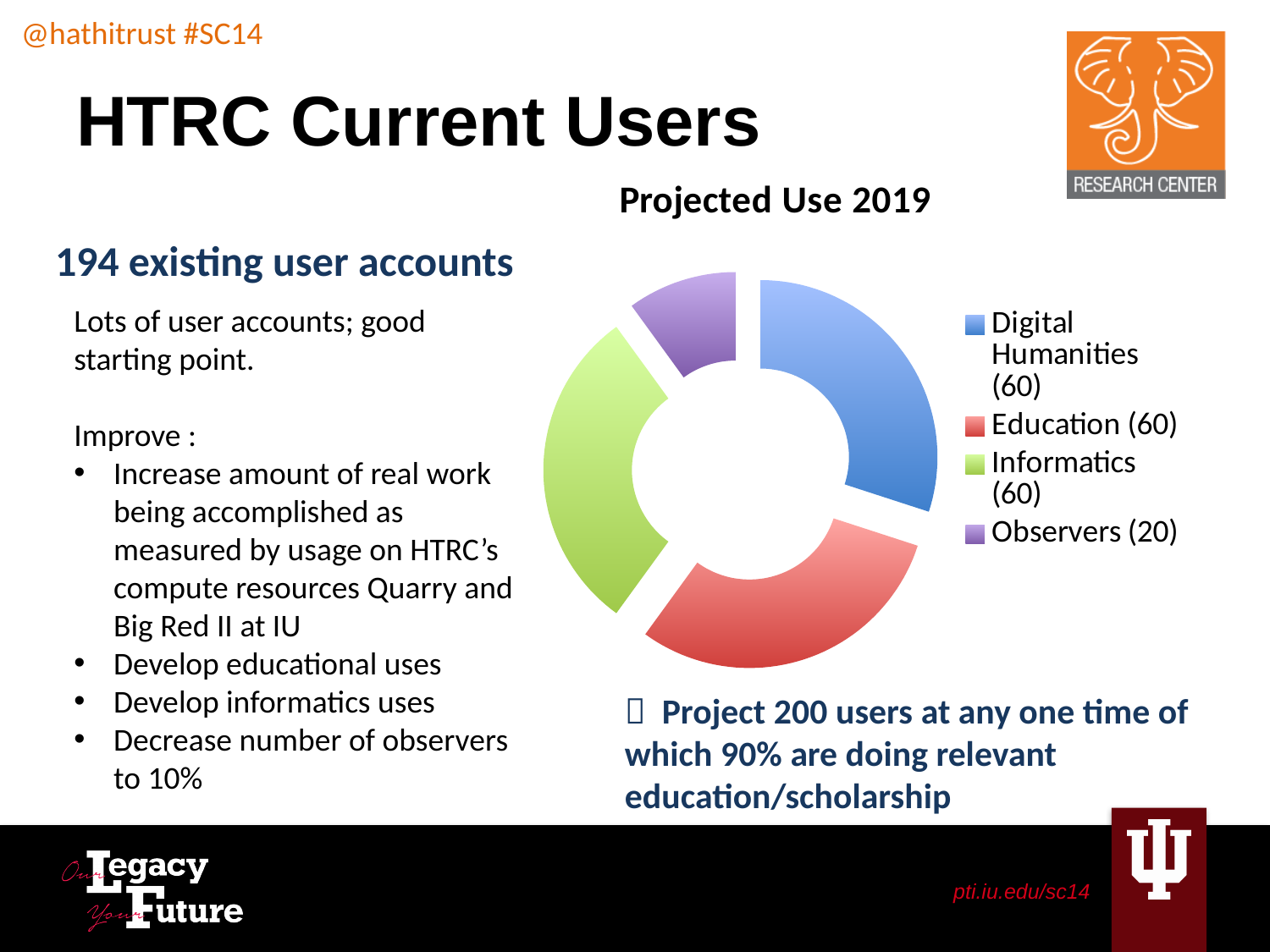
What kind of chart is the Projected Use 2019 chart? Doughnut (pie) chart How many categories does the Projected Use 2019 chart show? 4 What is the value for Informatics in the Projected Use 2019 chart? 60 What colour represents Informatics in the Projected Use 2019 chart? Green What is the value for Education in the Projected Use 2019 chart? 60 Which is larger in the Projected Use 2019 chart, Informatics or Observers? Informatics What is the value for Digital Humanities in the Projected Use 2019 chart? 60 What is the total of all categories in the Projected Use 2019 chart? 200 Which category has the lowest value in the Projected Use 2019 chart? Observers What is the difference between the values for Education and Observers in the Projected Use 2019 chart? 40 What share of the total does Observers represent in the Projected Use 2019 chart? 10% What is the value for Observers in the Projected Use 2019 chart? 20